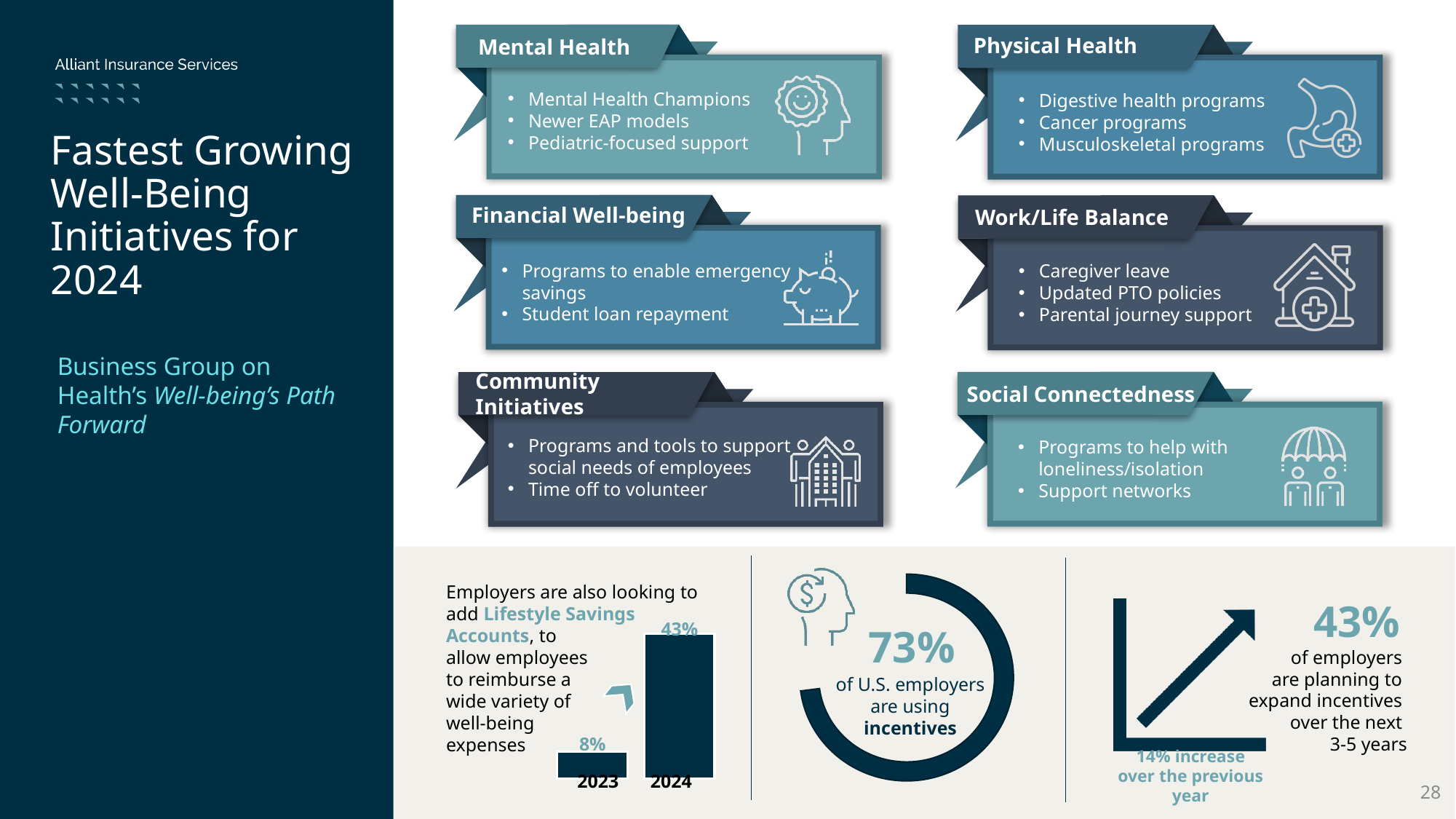
In the bar chart about Lifestyle Savings Accounts at the bottom left, what is the value for 2024? 43% How many bars are shown in the bar chart about Lifestyle Savings Accounts? 2 What kind of chart is used to show the Lifestyle Savings Accounts data for 2023 and 2024? bar chart In the bar chart about Lifestyle Savings Accounts, do the values rise or fall from 2023 to 2024? rise In the circular chart in the bottom middle of the slide, what percentage of U.S. employers are using incentives? 73% In the bar chart about Lifestyle Savings Accounts, which year has the higher value? 2024 In the bar chart about Lifestyle Savings Accounts, by how many percentage points does the 2024 value exceed the 2023 value? 35 percentage points Which two years are labelled on the x axis of the bar chart about Lifestyle Savings Accounts? 2023 and 2024 What kind of chart is used in the bottom middle of the slide to show the share of U.S. employers using incentives? donut chart In the bar chart about Lifestyle Savings Accounts, which year has the lower value? 2023 In the bar chart about Lifestyle Savings Accounts, is the value for 2024 larger or smaller than the value for 2023? larger In the bar chart about Lifestyle Savings Accounts at the bottom left, what is the value for 2023? 8%